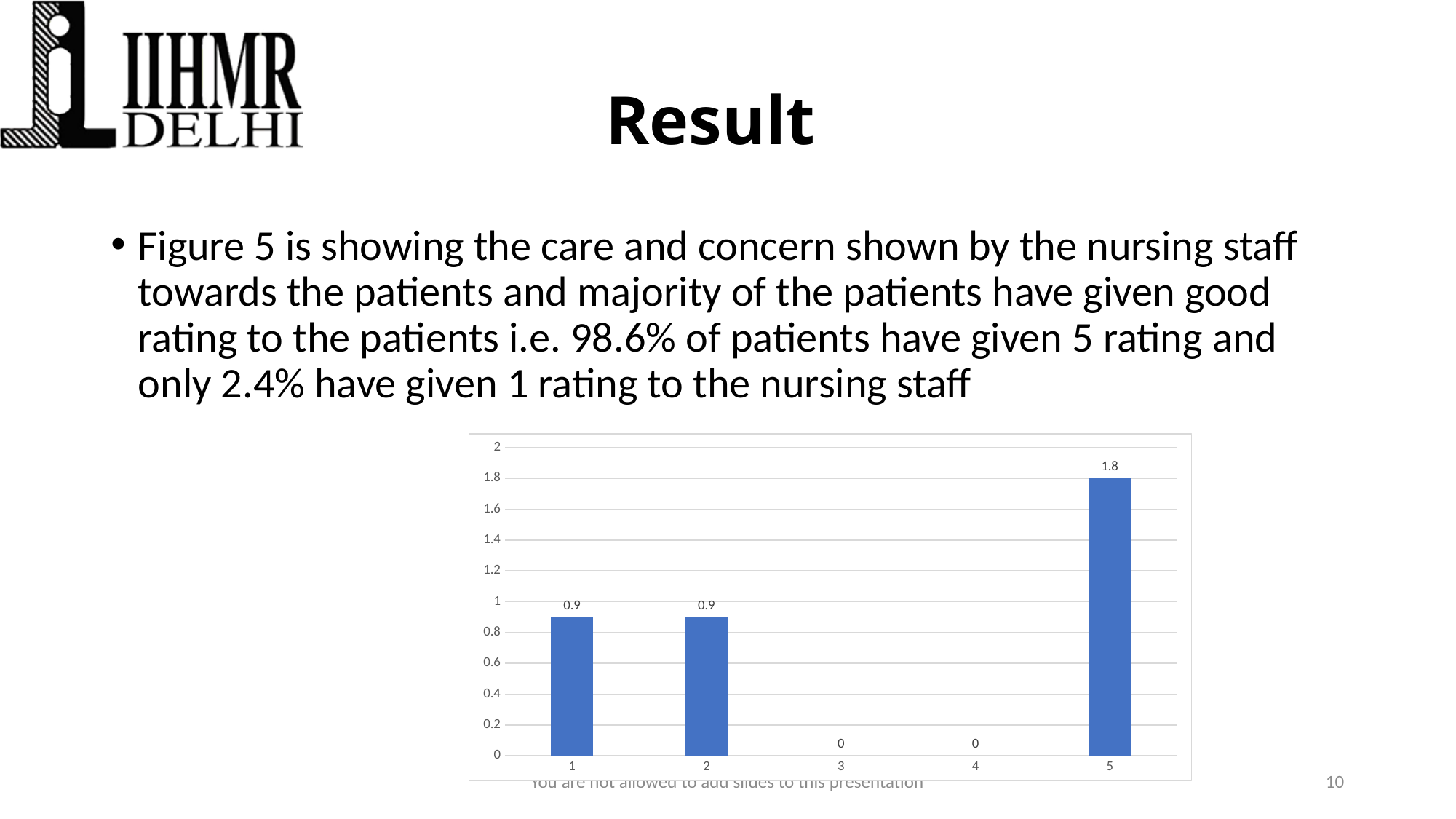
How many categories in the chart have a value of 0? 2 What kind of chart is shown on the slide? bar chart What is the maximum value shown on the y axis of the chart? 2 What colour are the bars in the chart? blue Which is larger, the value for category 1 or the value for category 5? category 5 What is the value for category 3 in the chart? 0 Is the value for category 5 greater or less than 1? greater What is the value for category 5 in the chart? 1.8 Which category has the highest value in the chart? 5 How many categories are shown on the x axis of the chart? 5 What is the value for category 1 in the chart? 0.9 What is the difference between the values for category 5 and category 2? 0.9